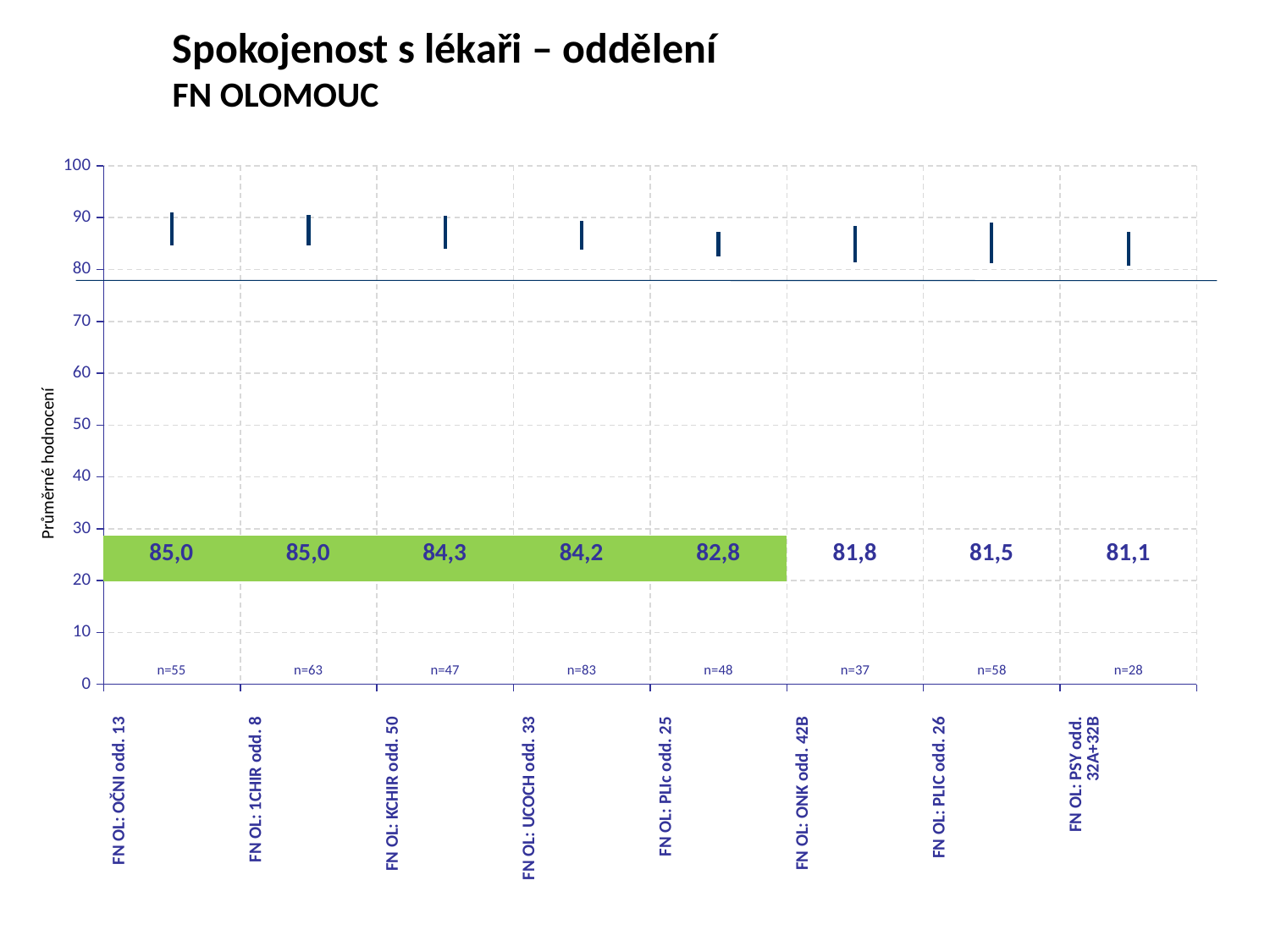
What is the average rating for FN OL: PSY odd. 32A+32B? 81,1 What is the average rating for FN OL: ONK odd. 42B? 81,8 Which has a higher average rating, FN OL: PLIc odd. 25 or FN OL: PLIC odd. 26? FN OL: PLIc odd. 25 Is the average rating for FN OL: 1CHIR odd. 8 greater or less than 80? greater What is the difference between the average rating of FN OL: OČNI odd. 13 and FN OL: PSY odd. 32A+32B? 3,9 Do the average ratings rise or fall from left to right across the departments? fall What is the average rating (průměrné hodnocení) for FN OL: KCHIR odd. 50? 84,3 What is the label of the vertical axis? Průměrné hodnocení How many departments are shown on the chart? 8 How many respondents (n) are shown for FN OL: UCOCH odd. 33? n=83 Which department has the largest number of respondents (n)? FN OL: UCOCH odd. 33 Which department has the lowest average rating? FN OL: PSY odd. 32A+32B